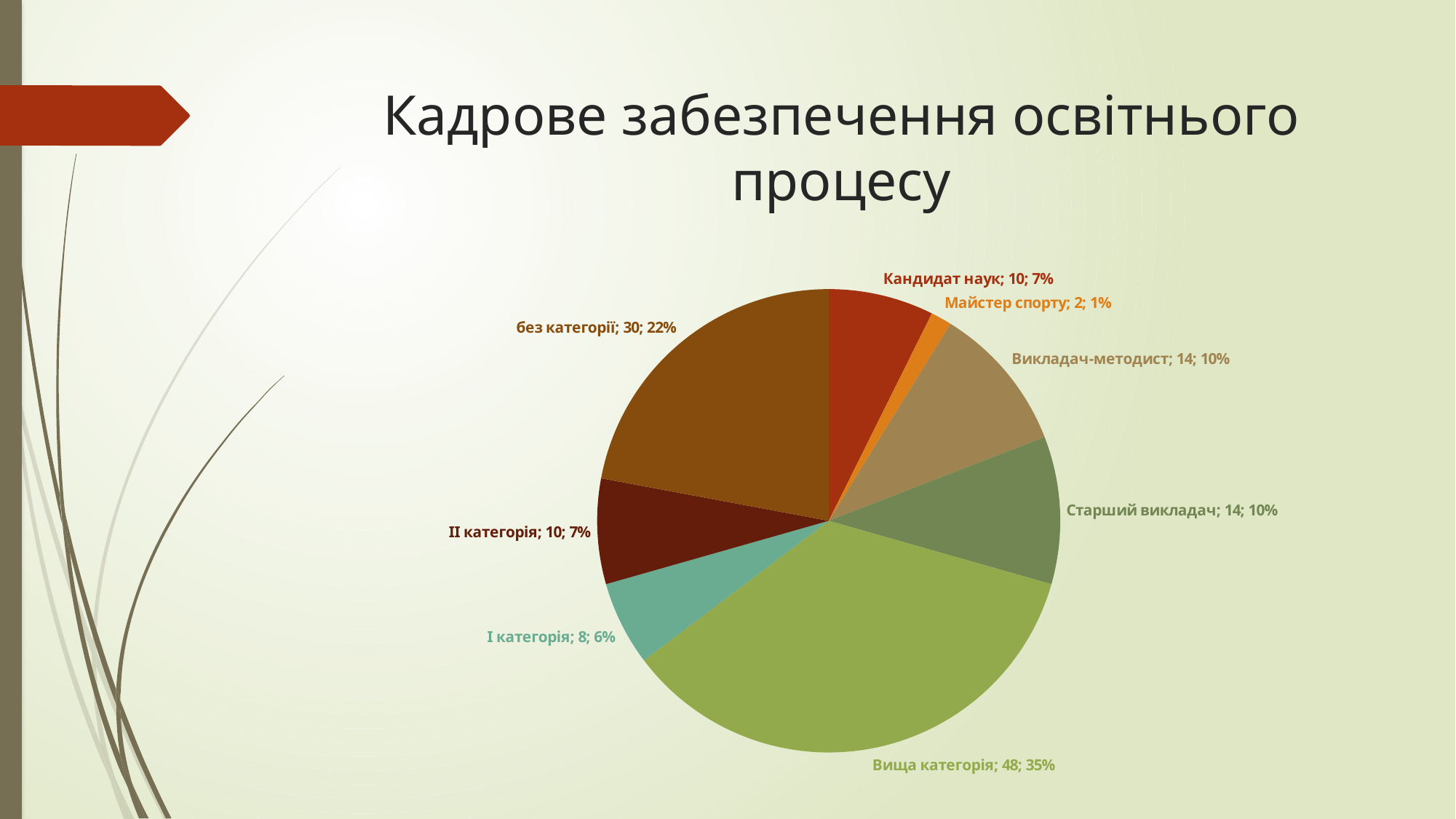
What is the value for Майстер спорту? 2 Which is larger, the value for I категорія or the value for II категорія? II категорія What is the title of the slide containing the chart? Кадрове забезпечення освітнього процесу How many slices does the pie chart have? 8 What is the difference between the values for Вища категорія and без категорії? 18 What percentage share does без категорії have? 22% Which category has the smallest slice? Майстер спорту What is the total of all the values shown in the pie chart? 136 What percentage share does Старший викладач have? 10% Which category has the largest slice? Вища категорія What is the value for Вища категорія? 48 What kind of chart is shown on the slide? pie chart